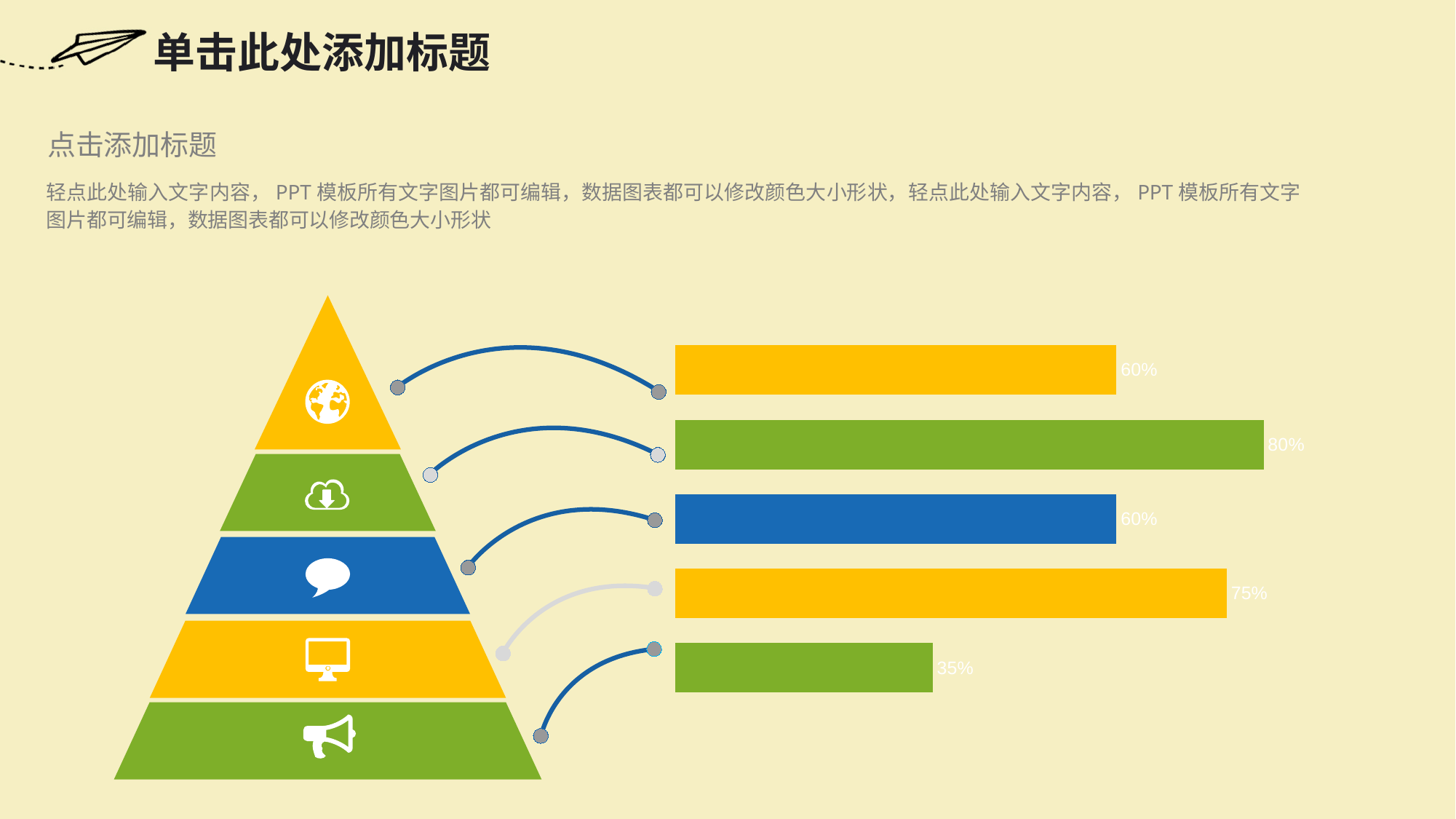
How many levels does the pyramid on the left of the slide have? 5 Which bar has the highest value? The second bar from the top (80%) What value is shown on the fourth bar from the top? 75% Which bar has the lowest value? The bottom bar (35%) How many bars are in the bar chart? 5 What is the difference between the highest bar value (80%) and the lowest bar value (35%)? 45% What value is shown on the top bar of the bar chart? 60% What value is shown on the bottom bar? 35% What value is shown on the second bar from the top? 80% What value is shown on the blue bar (third from the top)? 60% Which is larger, the value of the fourth bar from the top or the value of the top bar? The fourth bar (75%) What kind of chart is shown on the right side of the slide? Bar chart